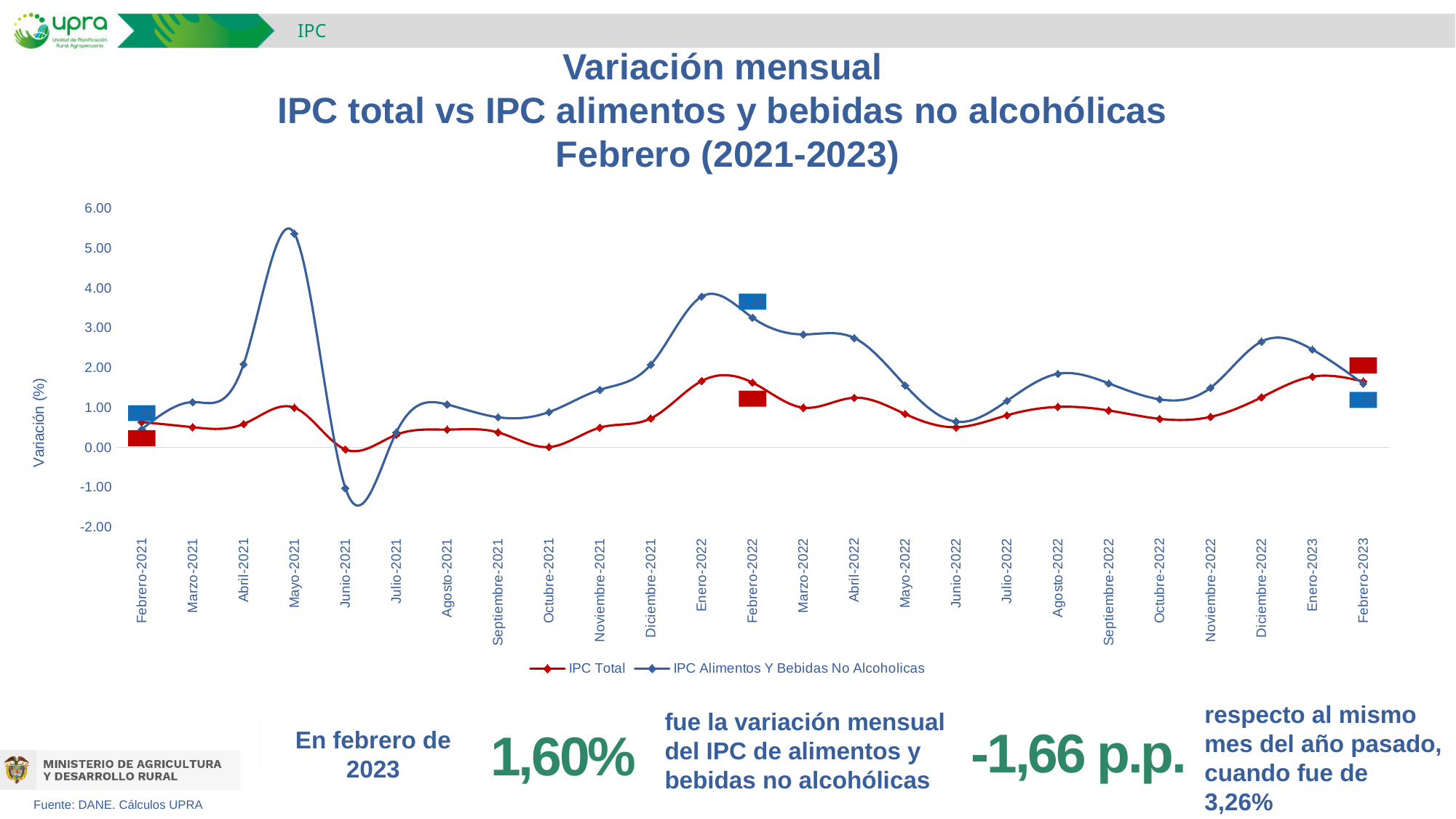
In which month does the IPC Alimentos Y Bebidas No Alcoholicas series reach its highest value? Mayo-2021 How many series does the legend list? 2 In which month does the IPC Alimentos Y Bebidas No Alcoholicas series reach its lowest value? Junio-2021 Is the value of IPC Alimentos Y Bebidas No Alcoholicas in Junio-2021 greater or less than 0.00? less Is the value of IPC Alimentos Y Bebidas No Alcoholicas in Mayo-2021 greater or less than 5.00? greater Which colour is used for the IPC Total series? red According to the slide, what was the monthly variation of the IPC de alimentos y bebidas no alcohólicas in February 2023? 1,60% What kind of chart is shown on the slide? line chart Is the value of IPC Alimentos Y Bebidas No Alcoholicas in Enero-2022 greater or less than 3.00? greater How many months are plotted along the x axis? 25 Does the IPC Alimentos Y Bebidas No Alcoholicas series rise or fall from Febrero-2021 to Mayo-2021? rise In Mayo-2021, which series has the larger value, IPC Total or IPC Alimentos Y Bebidas No Alcoholicas? IPC Alimentos Y Bebidas No Alcoholicas